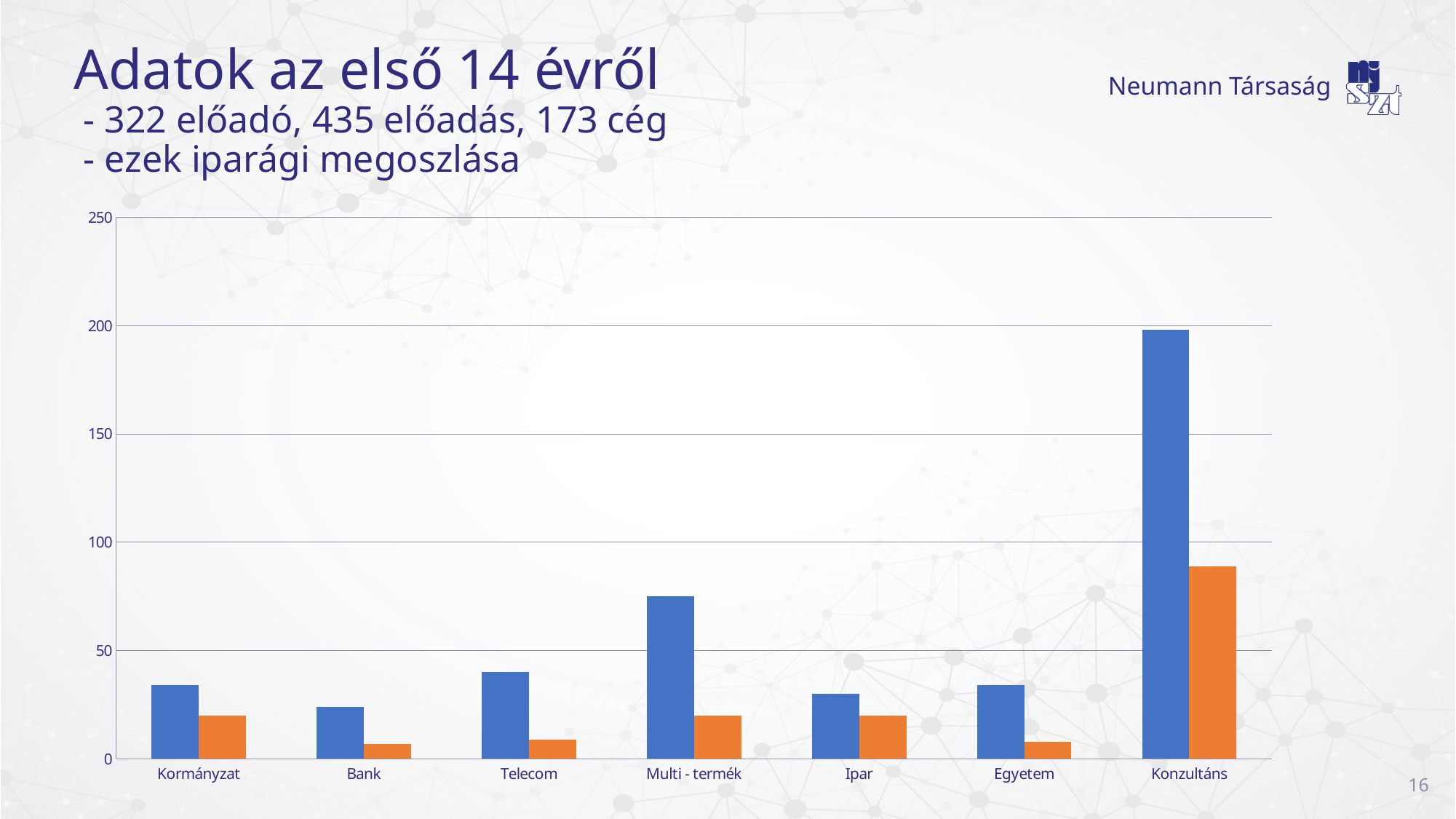
Is the blue bar for Multi - termék greater or less than 50? greater What is the highest value shown on the y axis of the chart? 250 Is the blue bar for Telecom greater or less than 50? less Is the orange bar for Bank greater or less than 50? less How many categories are shown on the x axis of the chart? 7 How many data series (bar colours) are plotted for each category? 2 Which category has the tallest orange bar? Konzultáns Which is larger: the blue bar for Multi - termék or the blue bar for Telecom? Multi - termék What kind of chart is shown on the slide? bar chart Which category has the tallest blue bar? Konzultáns